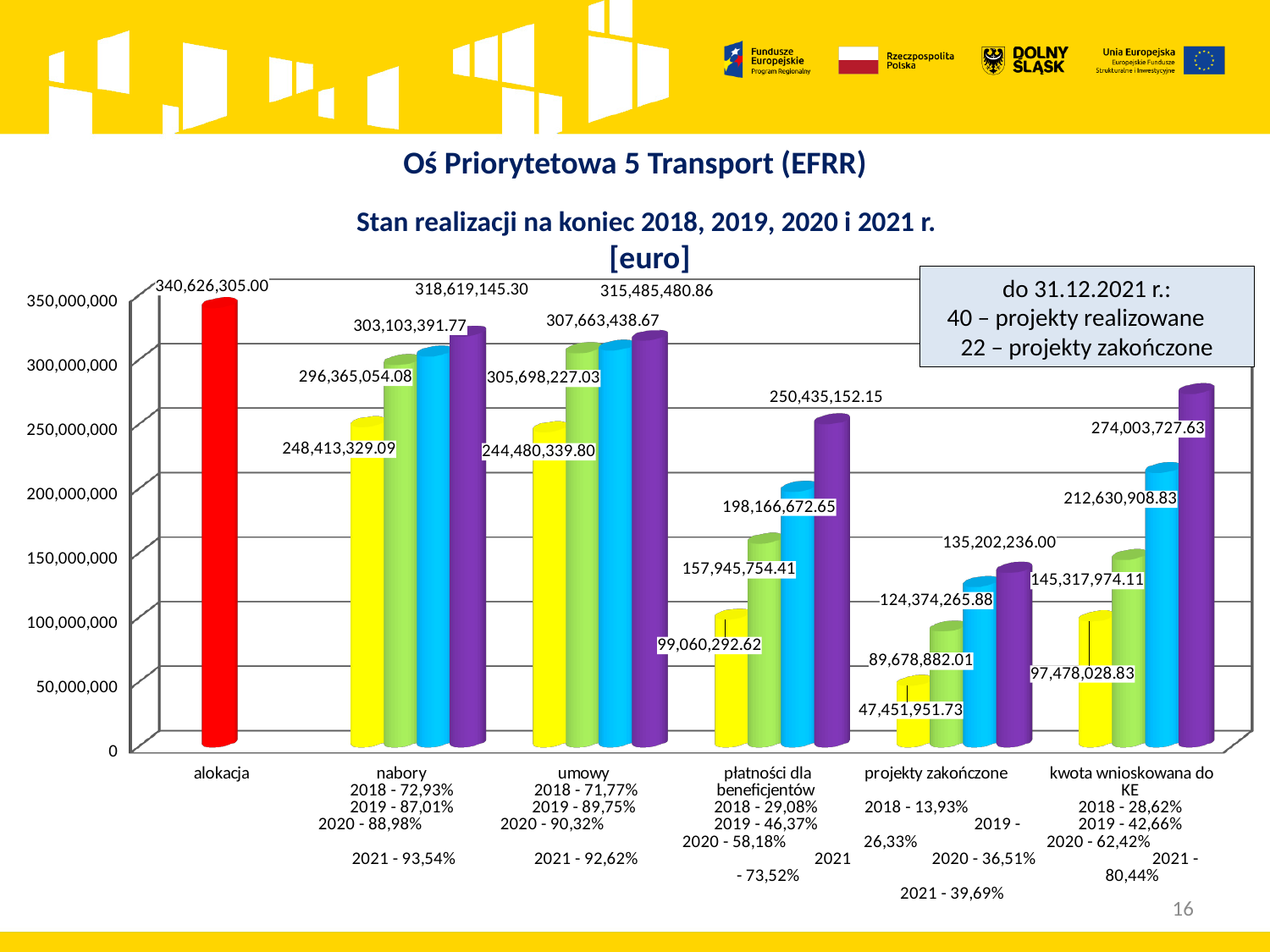
What is the value of the yellow bar in the projekty zakończone group? 47,451,951.73 What is the value of the blue bar in the kwota wnioskowana do KE group? 212,630,908.83 What is the value of the alokacja bar? 340,626,305.00 What is the difference between the alokacja bar (340,626,305.00) and the purple bar in the umowy group (315,485,480.86)? 25,140,824.14 Which category contains the lowest bar on the chart? projekty zakończone What is the value of the tallest (purple) bar in the nabory group? 318,619,145.30 What is the value of the purple bar in the płatności dla beneficjentów group? 250,435,152.15 What type of chart is shown on the slide? bar chart Is the green bar in the płatności dla beneficjentów group greater or less than 150,000,000? greater Which is larger: the purple bar in the projekty zakończone group or the purple bar in the kwota wnioskowana do KE group? kwota wnioskowana do KE Which category has the single highest bar on the chart? alokacja What is the value of the shortest (yellow) bar in the umowy group? 244,480,339.80